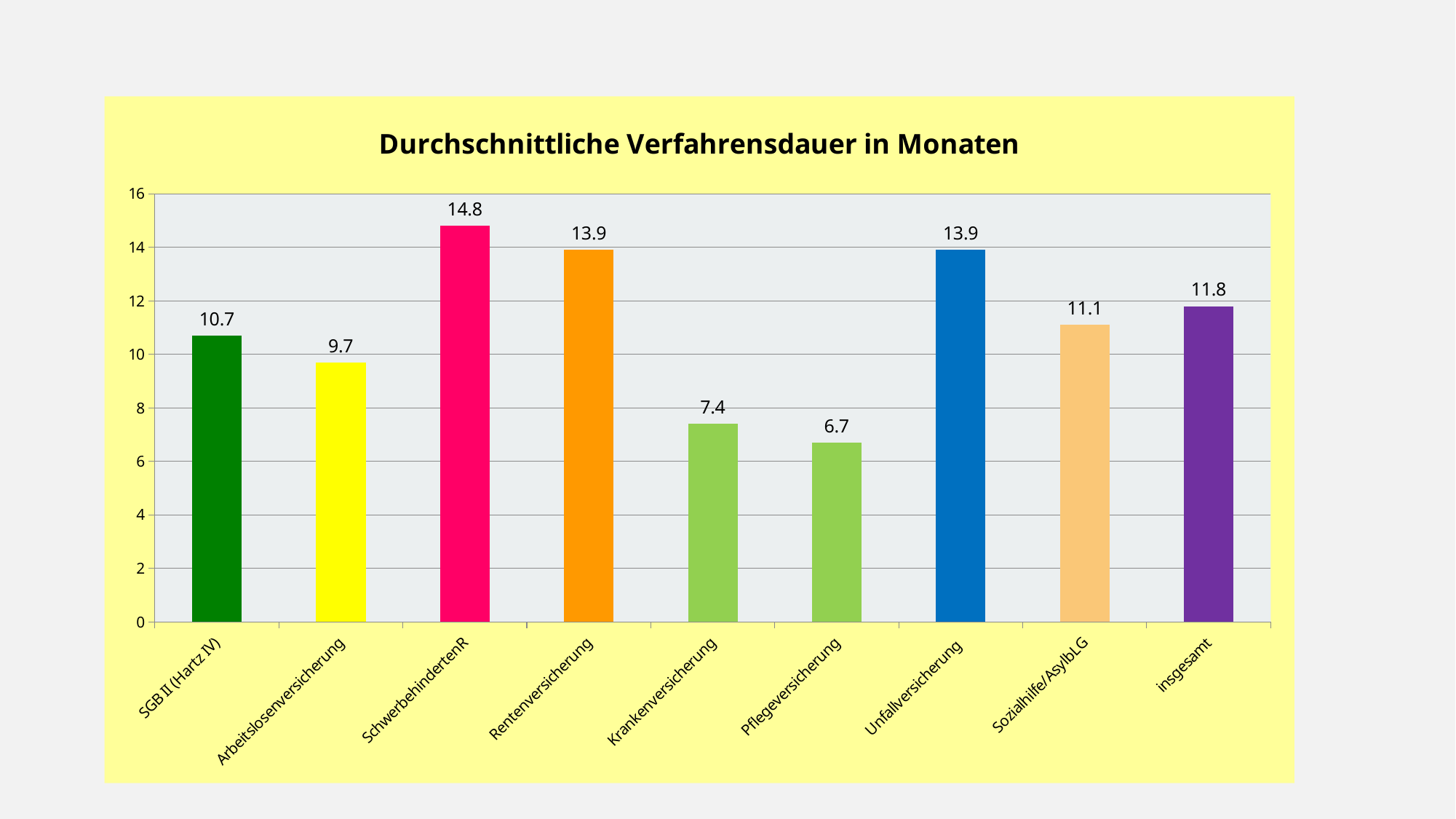
What is the difference between the values for SchwerbehindertenR and Pflegeversicherung? 8.1 What is the value for Pflegeversicherung? 6.7 How many categories are shown on the x axis? 9 What is the value for Sozialhilfe/AsylbLG? 11.1 Which category has the lowest value? Pflegeversicherung Which category has the highest value? SchwerbehindertenR What is the value for insgesamt? 11.8 What is the value for SchwerbehindertenR? 14.8 What kind of chart is shown on the slide? bar chart What is the title of the chart? Durchschnittliche Verfahrensdauer in Monaten What is the difference between the values for SGB II (Hartz IV) and Arbeitslosenversicherung? 1.0 Which is larger, the value for Krankenversicherung or the value for Sozialhilfe/AsylbLG? Sozialhilfe/AsylbLG